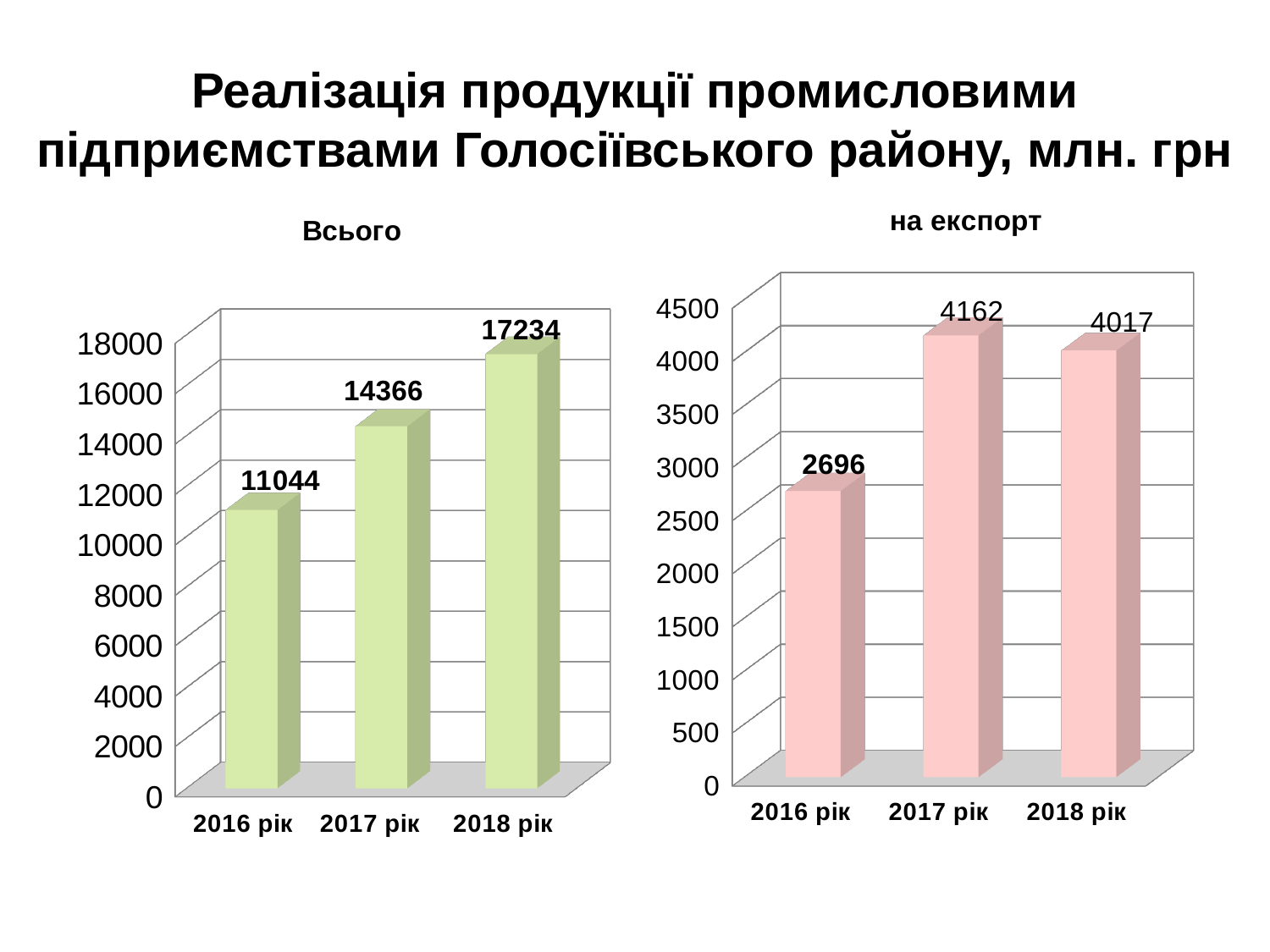
In the 'Всього' chart, what is the difference between the values for 2018 рік and 2017 рік? 2868 In the 'Всього' chart, what is the value for 2016 рік? 11044 In the 'Всього' chart, do the values rise or fall from 2016 рік to 2018 рік? rise In the 'на експорт' chart, what is the value for 2017 рік? 4162 What kind of chart is the 'на експорт' chart? bar chart In the 'Всього' chart, which year has the highest value? 2018 рік In the 'на експорт' chart, which is larger, the value for 2017 рік or 2018 рік? 2017 рік How many bars are in the 'Всього' chart? 3 In the 'на експорт' chart, what is the value for 2016 рік? 2696 In the 'на експорт' chart, what is the difference between the values for 2017 рік and 2018 рік? 145 In the 'Всього' chart, what is the value for 2018 рік? 17234 In the 'на експорт' chart, which year has the lowest value? 2016 рік